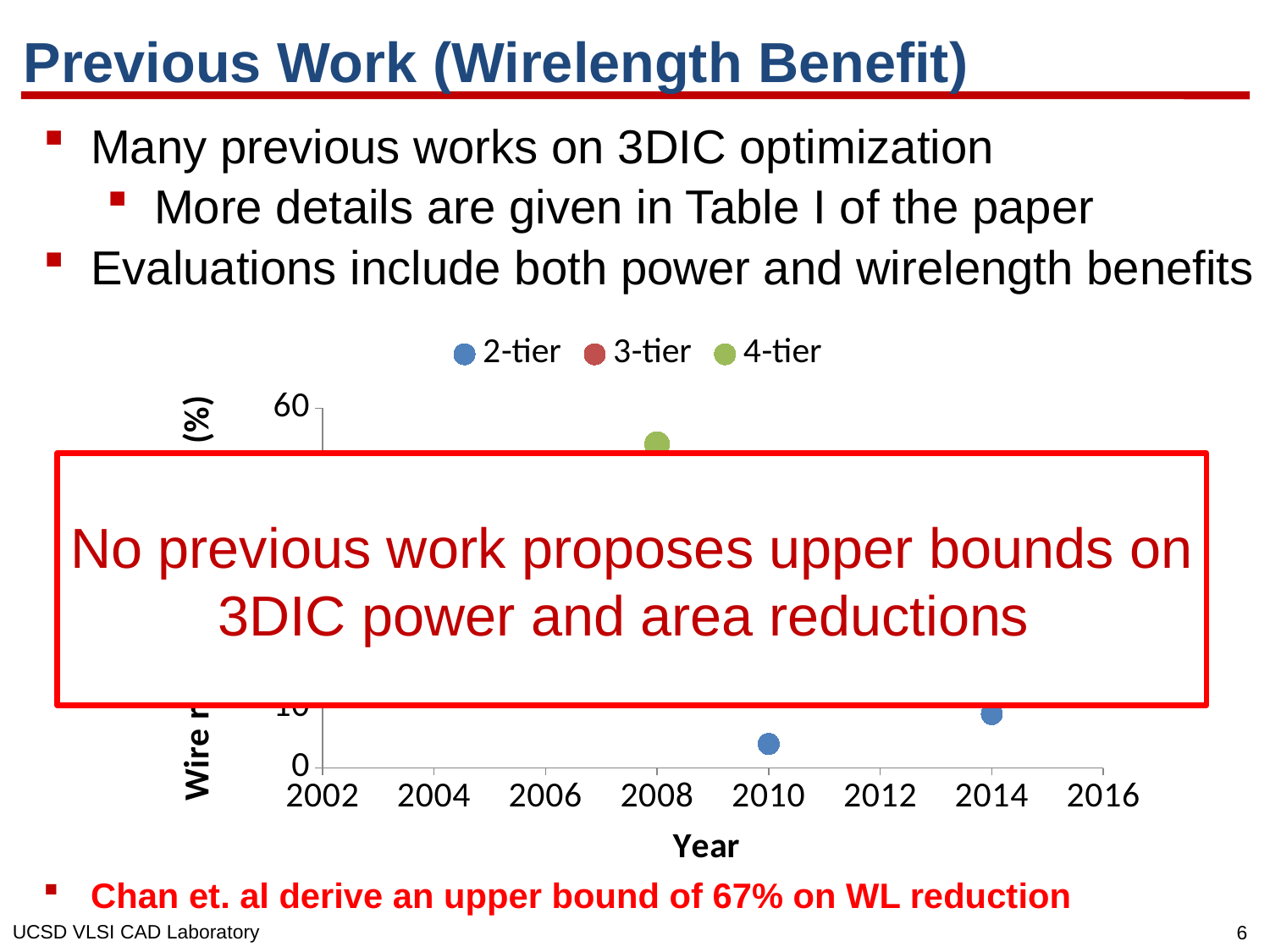
Is the value of the 2-tier point at 2010 greater or less than 10? less Which series is plotted in green on the chart? 4-tier Is the value of the 4-tier point at 2008 greater or less than 10? greater Which is larger: the 2-tier point at 2010 or the 2-tier point at 2014? the 2-tier point at 2014 What is the title of the chart's x axis? Year What kind of chart is shown on the slide? scatter chart How many series does the chart legend list? 3 Which is larger: the 4-tier point at 2008 or the 2-tier point at 2010? the 4-tier point at 2008 What are the series names listed in the chart legend? 2-tier, 3-tier, 4-tier